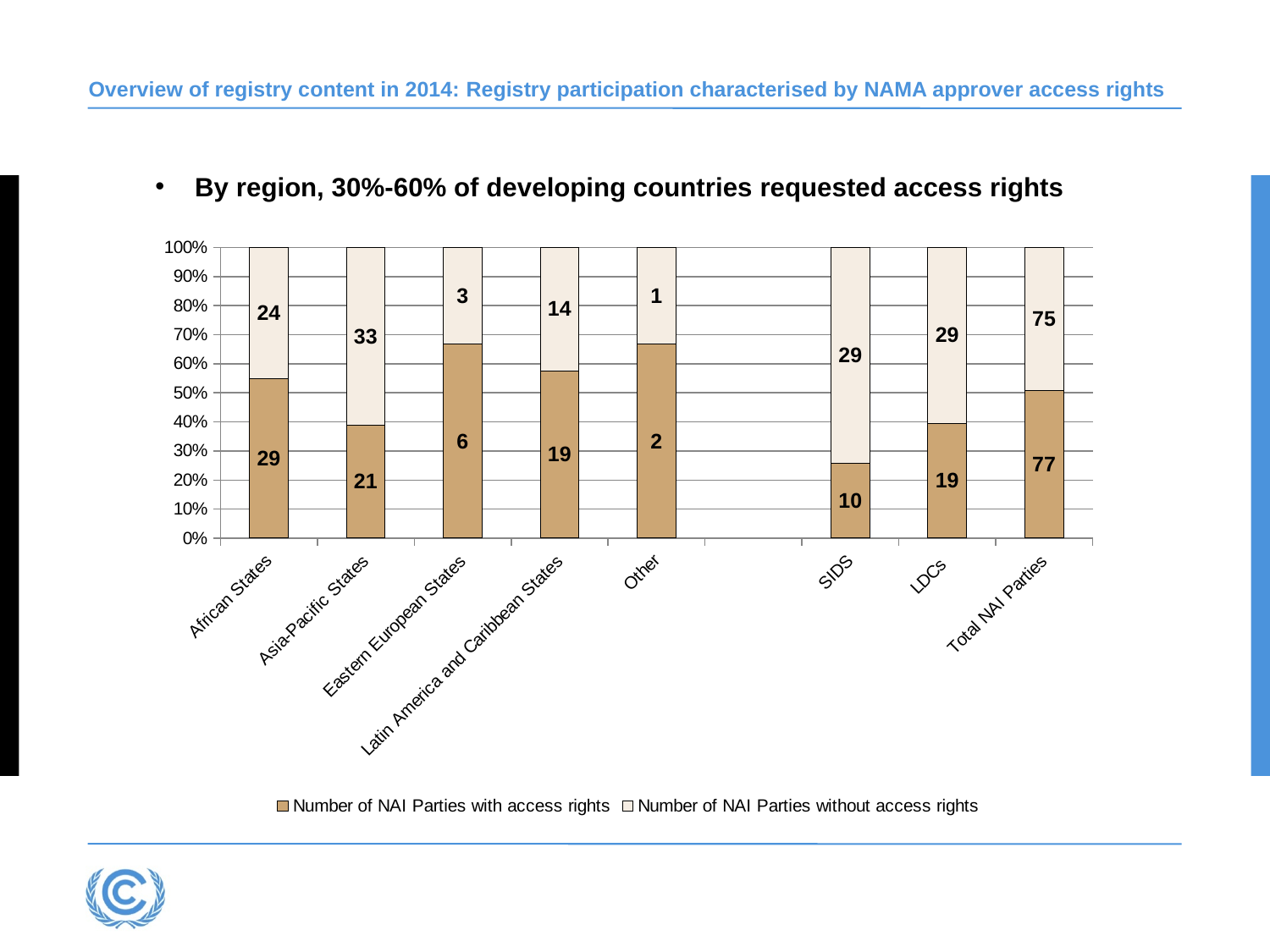
Is the share of NAI Parties with access rights for SIDS greater or less than 30%? less Which category has the lowest number of NAI Parties with access rights? Other How many series does the legend list? 2 What is the difference between the number of NAI Parties without access rights and with access rights for SIDS? 19 Which category has the highest number of NAI Parties without access rights? Total NAI Parties How many categories are shown on the x axis of the chart? 8 How many NAI Parties without access rights are shown for Asia-Pacific States? 33 How many NAI Parties with access rights are shown for African States? 29 What is the number of NAI Parties with access rights for Total NAI Parties? 77 Which has more NAI Parties with access rights: African States or Asia-Pacific States? African States Is the share of NAI Parties with access rights for Eastern European States greater or less than 60%? greater What is the total number of NAI Parties (with and without access rights) for LDCs? 48